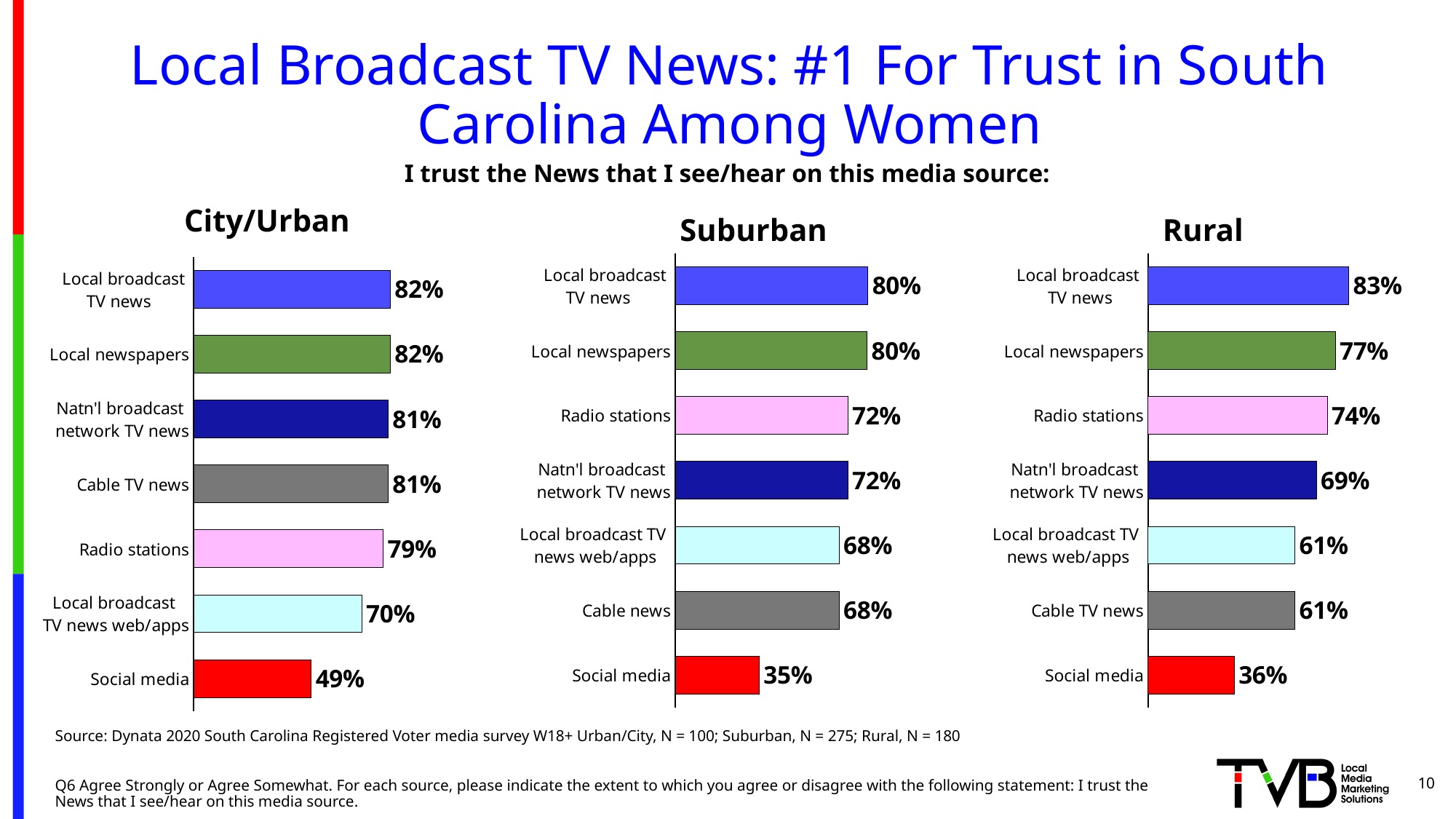
In the Suburban chart, what is the value for Radio stations? 72% In the Rural chart, what is the difference between Local broadcast TV news and Social media? 47% In the City/Urban chart, what is the value for Social media? 49% In the Suburban chart, which category has the lowest value? Social media In the City/Urban chart, what is the difference between Radio stations and Local broadcast TV news web/apps? 9% In the Rural chart, what is the value for Local newspapers? 77% In the Suburban chart, which is larger: Local newspapers or Cable news? Local newspapers In the Rural chart, which is larger: Radio stations or Natn'l broadcast network TV news? Radio stations In the Rural chart, which category has the highest value? Local broadcast TV news How many categories are shown in the City/Urban chart? 7 What colour is the Social media bar in each of the three charts? Red What kind of chart is the Suburban chart? Bar chart